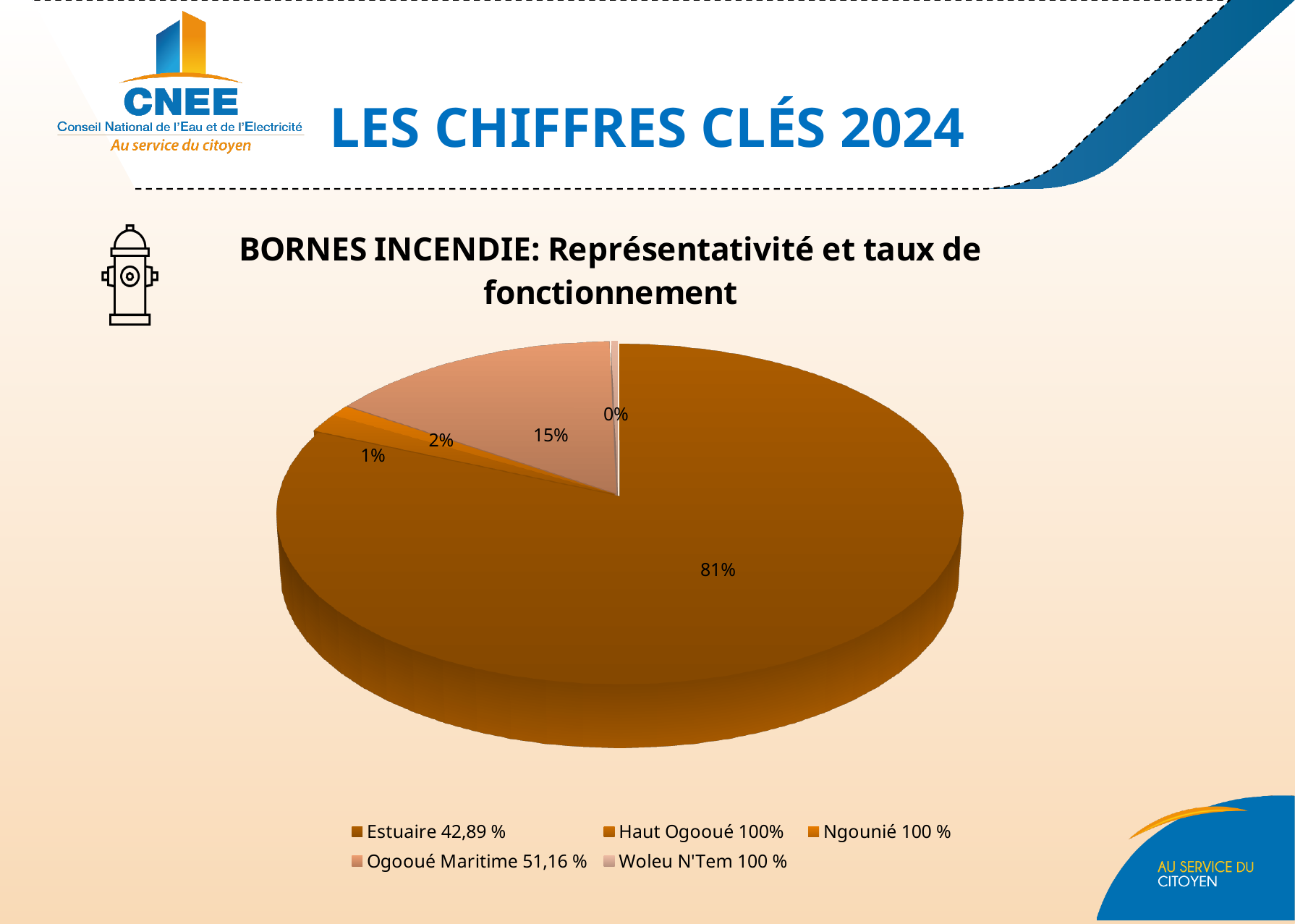
What share of the pie does Estuaire represent? 81% What is the title of the chart? BORNES INCENDIE: Représentativité et taux de fonctionnement What rate is written next to Estuaire in the legend? 42,89 % Which category has the smallest slice of the pie? Woleu N'Tem What share of the pie does Ogooué Maritime represent? 15% Which category has the largest slice of the pie? Estuaire Which slice is larger, Ogooué Maritime or Ngounié? Ogooué Maritime What kind of chart is shown on the slide? Pie chart How many categories (slices) does the pie chart have? 5 What percentage is shown for the Ngounié slice? 1% What is the difference in percentage points between the Estuaire slice and the Ogooué Maritime slice? 66 What percentage is shown for the Woleu N'Tem slice? 0%